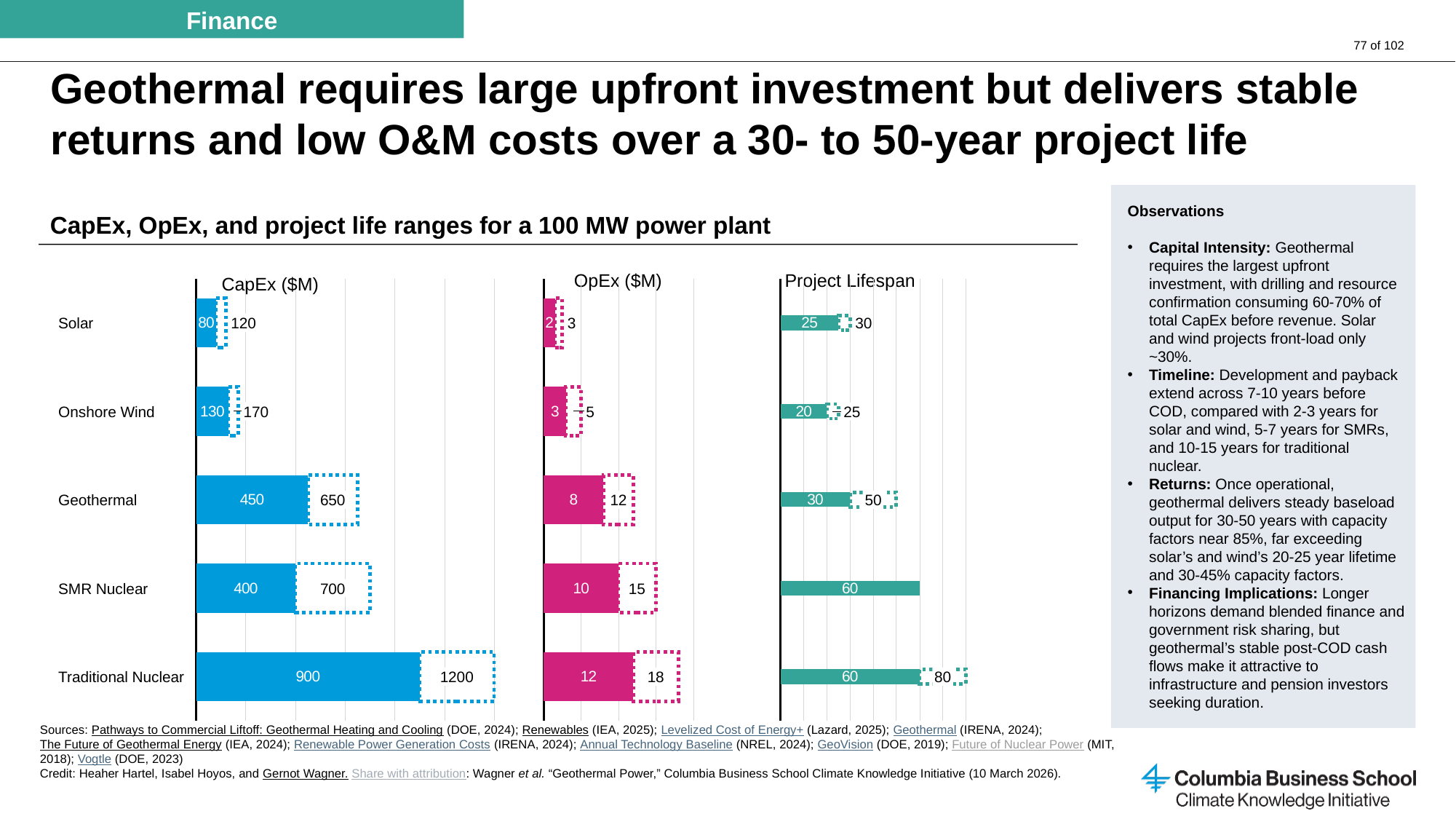
How many technologies are listed on the vertical axis of the charts? 5 In the CapEx ($M) chart, what is the difference between the high-end and low-end CapEx values for Geothermal? 200 What is the title of the chart group on the slide? CapEx, OpEx, and project life ranges for a 100 MW power plant In the Project Lifespan chart, what is the difference between the high-end lifespan of Traditional Nuclear and the high-end lifespan of Solar? 50 In the CapEx ($M) chart, what is the high-end CapEx value for Traditional Nuclear? 1200 In the Project Lifespan chart, what is the high-end lifespan value for Geothermal? 50 In the CapEx ($M) chart, what is the low-end CapEx value for Geothermal? 450 In the OpEx ($M) chart, what is the high-end OpEx value for SMR Nuclear? 15 In the CapEx ($M) chart, which is larger: the low-end CapEx for Geothermal or the low-end CapEx for SMR Nuclear? Geothermal In the CapEx ($M) chart, which technology has the highest high-end CapEx? Traditional Nuclear What type of chart is the OpEx ($M) chart? Bar chart In the OpEx ($M) chart, which technology has the lowest low-end OpEx? Solar